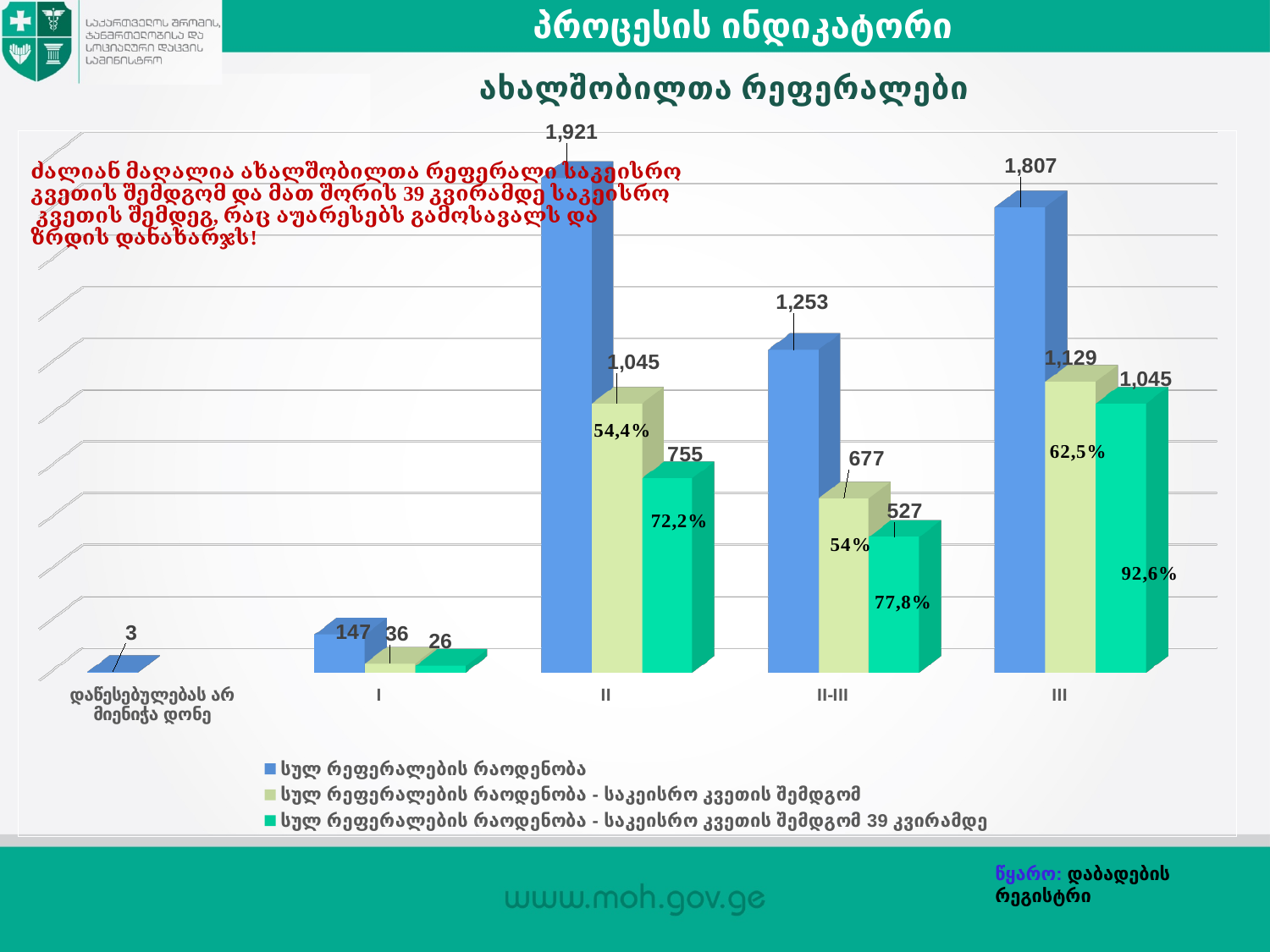
What is the value of the blue series (სულ რეფერალების რაოდენობა) for category II? 1,921 How many series does the legend list? 3 How many categories are shown on the x axis? 5 What is the value of the teal series (საკეისრო კვეთის შემდგომ 39 კვირამდე) for category III? 1,045 What is the value of the light green series (საკეისრო კვეთის შემდგომ) for category II-III? 677 Which is larger: the teal series value for category II or for category III? III What is the difference between the blue series values for categories II and III? 114 What percentage label is shown on the teal bar for category III? 92,6% What type of chart is shown on the slide? bar chart What is the title of the chart? ახალშობილთა რეფერალები Which category has the highest value for the blue series (სულ რეფერალების რაოდენობა)? II Which category has the lowest value for the blue series (სულ რეფერალების რაოდენობა)? დაწესებულებას არ მიენიჭა დონე